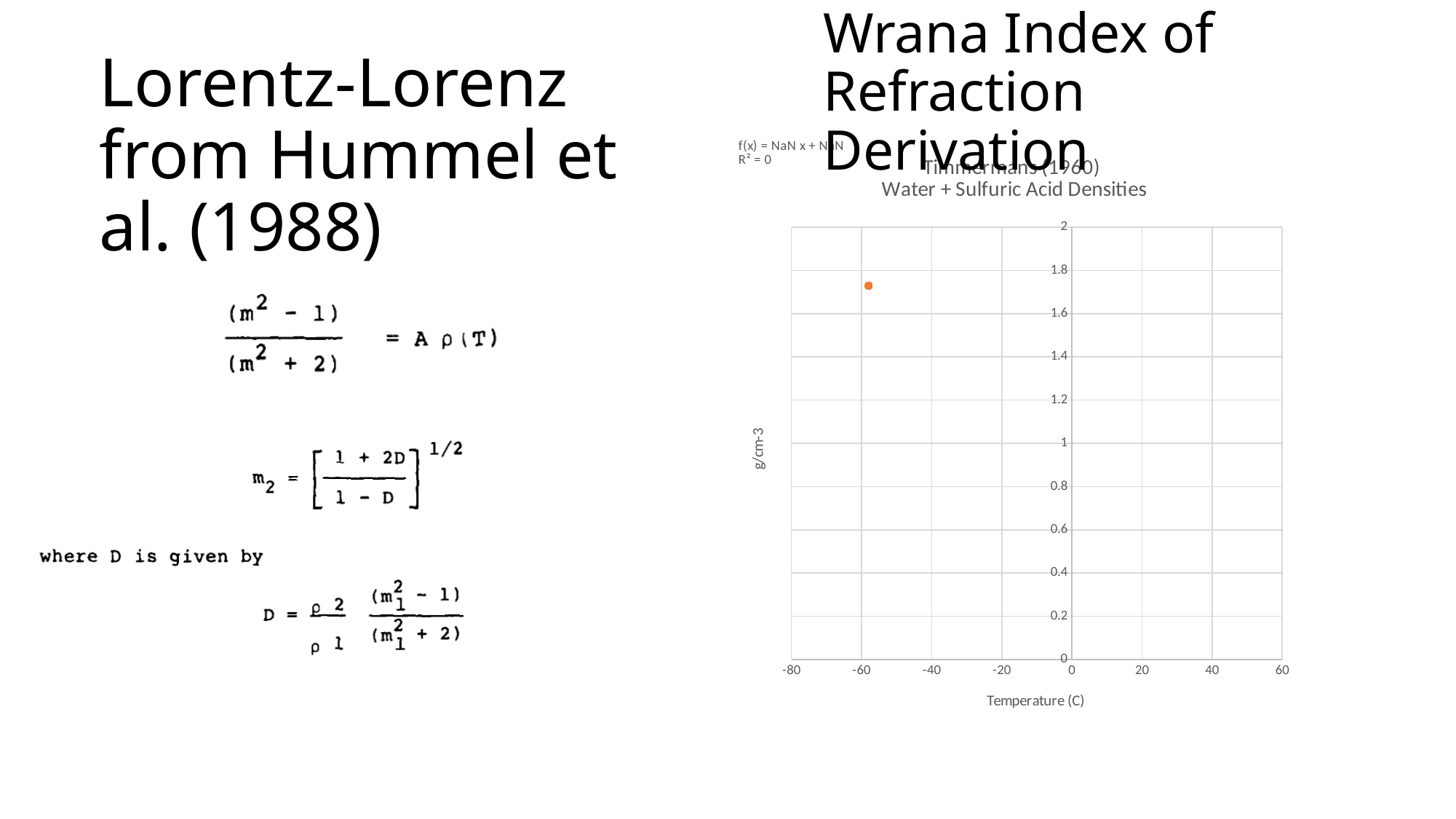
Is the density value of the plotted point greater or less than 1.6 g/cm-3? greater Is the density value of the plotted point greater or less than 1.8 g/cm-3? less Is the density value of the plotted point greater or less than 1? greater What kind of chart is shown on the slide? scatter chart What is the label of the x axis of the chart? Temperature (C) What is the label of the y axis of the chart? g/cm-3 How many data points are plotted on the chart? 1